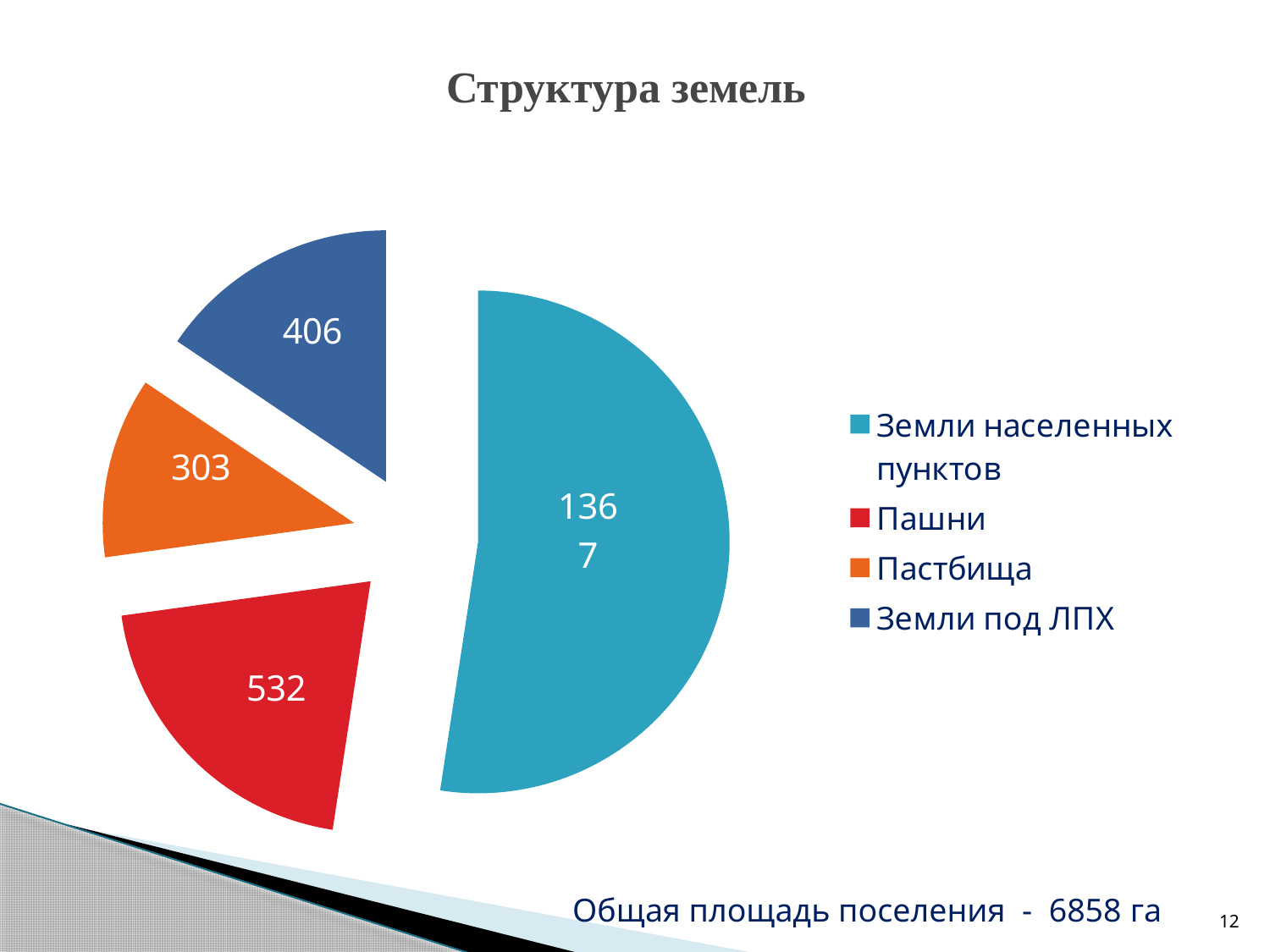
What type of chart is shown on the slide? pie chart What is the value for Земли населенных пунктов in the pie chart? 1367 Which is larger, the value for Пашни or the value for Земли под ЛПХ? Пашни What is the value for Земли под ЛПХ in the pie chart? 406 Which category has the smallest slice in the pie chart? Пастбища What is the difference between the values for Пашни and Пастбища? 229 What is the value for Пашни in the pie chart? 532 What is the title of the chart on the slide? Структура земель How many categories does the pie chart show? 4 What is the value for Пастбища in the pie chart? 303 Which category has the largest slice in the pie chart? Земли населенных пунктов What is the difference between the values for Земли под ЛПХ and Пастбища? 103